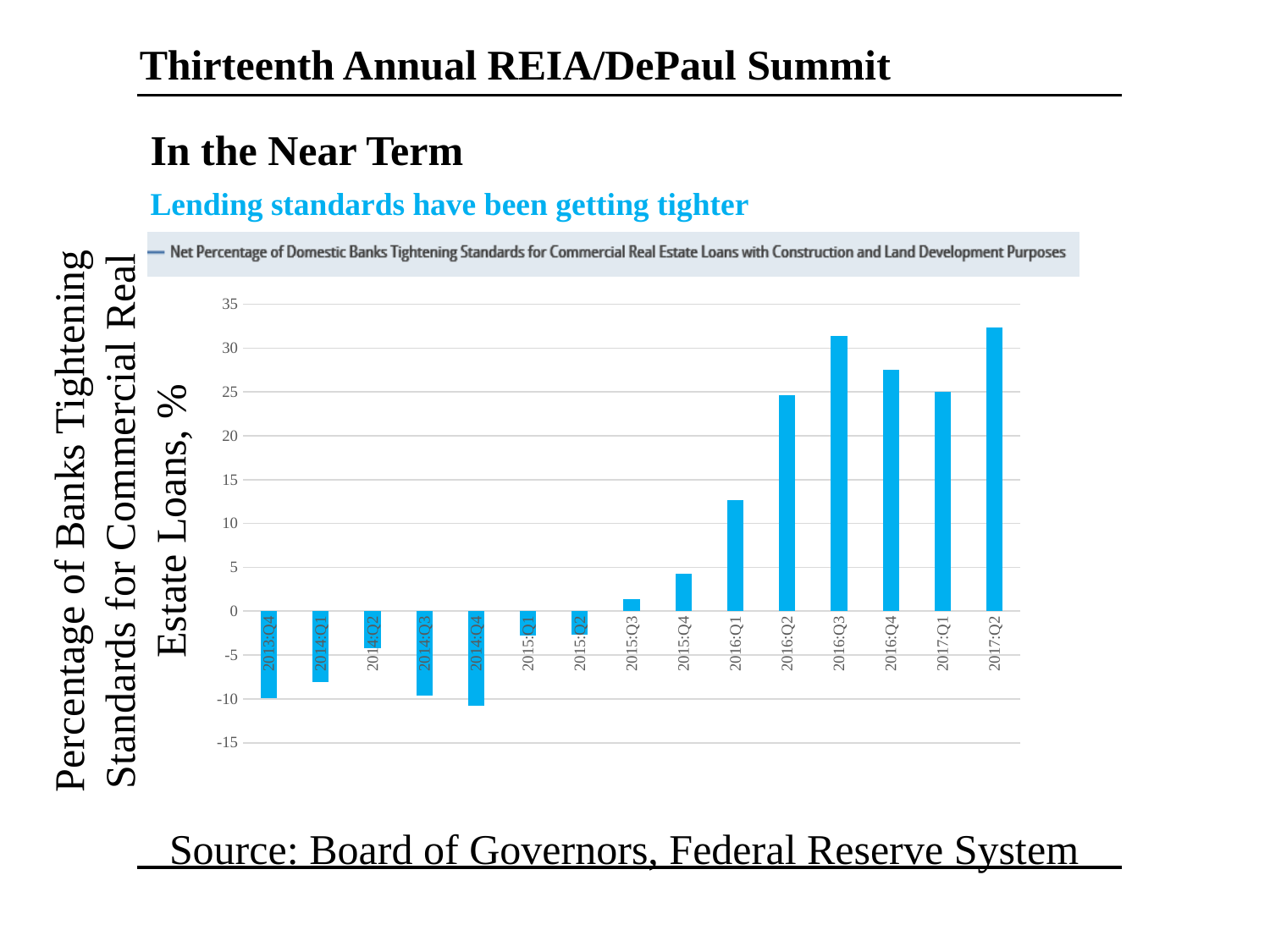
Is the value for 2014:Q2 greater or less than 0? less Is the value for 2015:Q4 greater or less than 5? less What kind of chart is shown on the slide? bar chart Which quarter has the highest net percentage of banks tightening standards? 2017:Q2 Is the value for 2016:Q3 greater or less than 30? greater Overall, do the values rise or fall from 2013:Q4 to 2017:Q2? rise What is the first quarter shown on the x axis of the chart? 2013:Q4 How many quarters (bars) are plotted in the chart? 15 How many series does the chart's legend list? 1 Which is larger, the value for 2015:Q1 or the value for 2014:Q1? 2015:Q1 Which is larger, the value for 2016:Q2 or the value for 2016:Q1? 2016:Q2